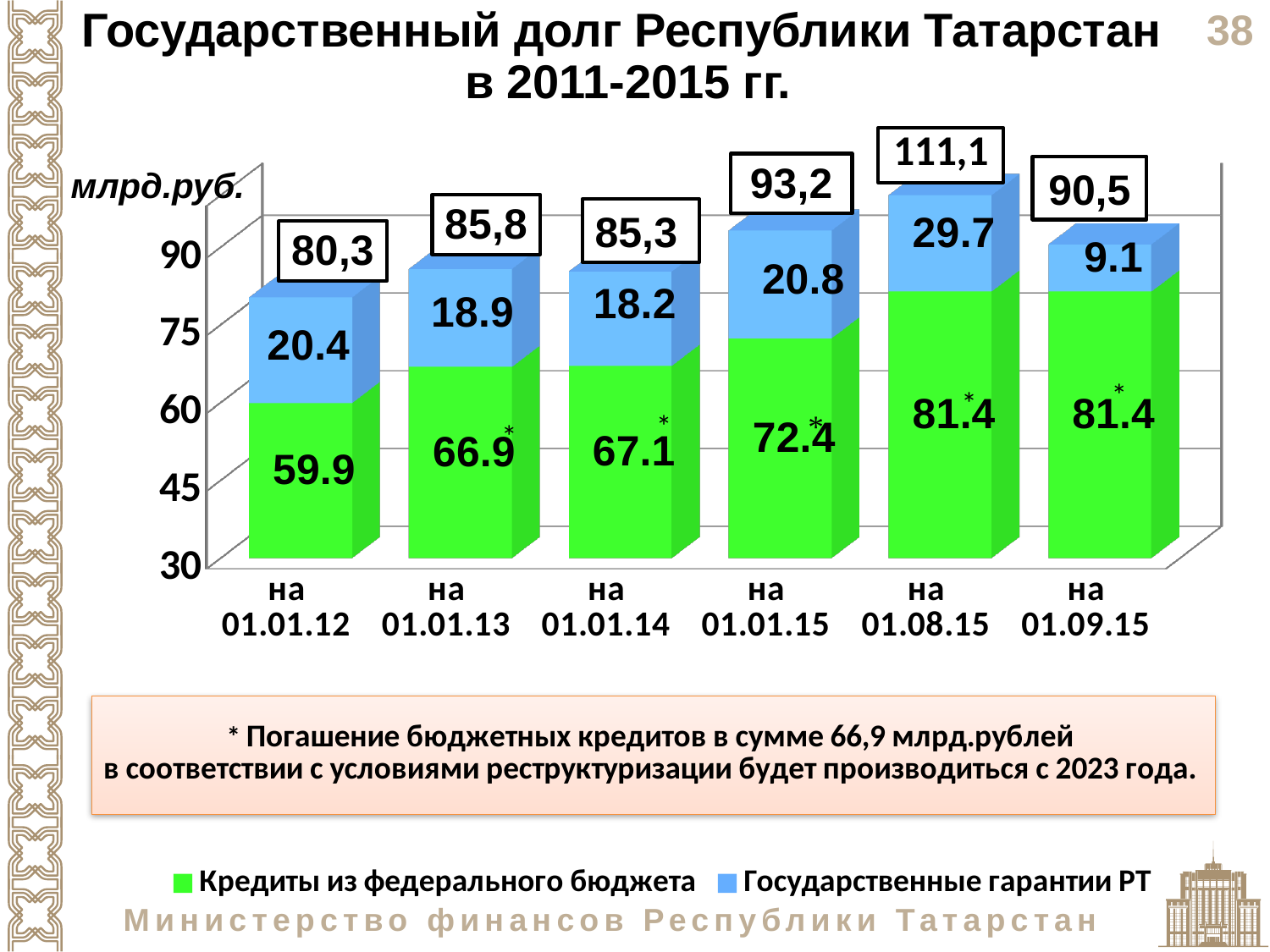
How many dates (categories) are shown on the x axis? 6 What is the difference between Государственные гарантии РТ на 01.08.15 and на 01.09.15? 20.6 How many series does the legend list? 2 On which date is the value of Государственные гарантии РТ lowest? на 01.09.15 What is the value of Кредиты из федерального бюджета на 01.01.12? 59.9 Which colour represents Государственные гарантии РТ in the chart? blue What is the total state debt shown above the bar for 01.01.15? 93,2 Does the value of Кредиты из федерального бюджета rise or fall from 01.01.12 to 01.08.15? rise On which date is the total state debt highest? на 01.08.15 What is the value of Государственные гарантии РТ на 01.08.15? 29.7 What kind of chart is shown on the slide? stacked bar chart Which is larger: Кредиты из федерального бюджета на 01.01.13 or на 01.01.14? на 01.01.14